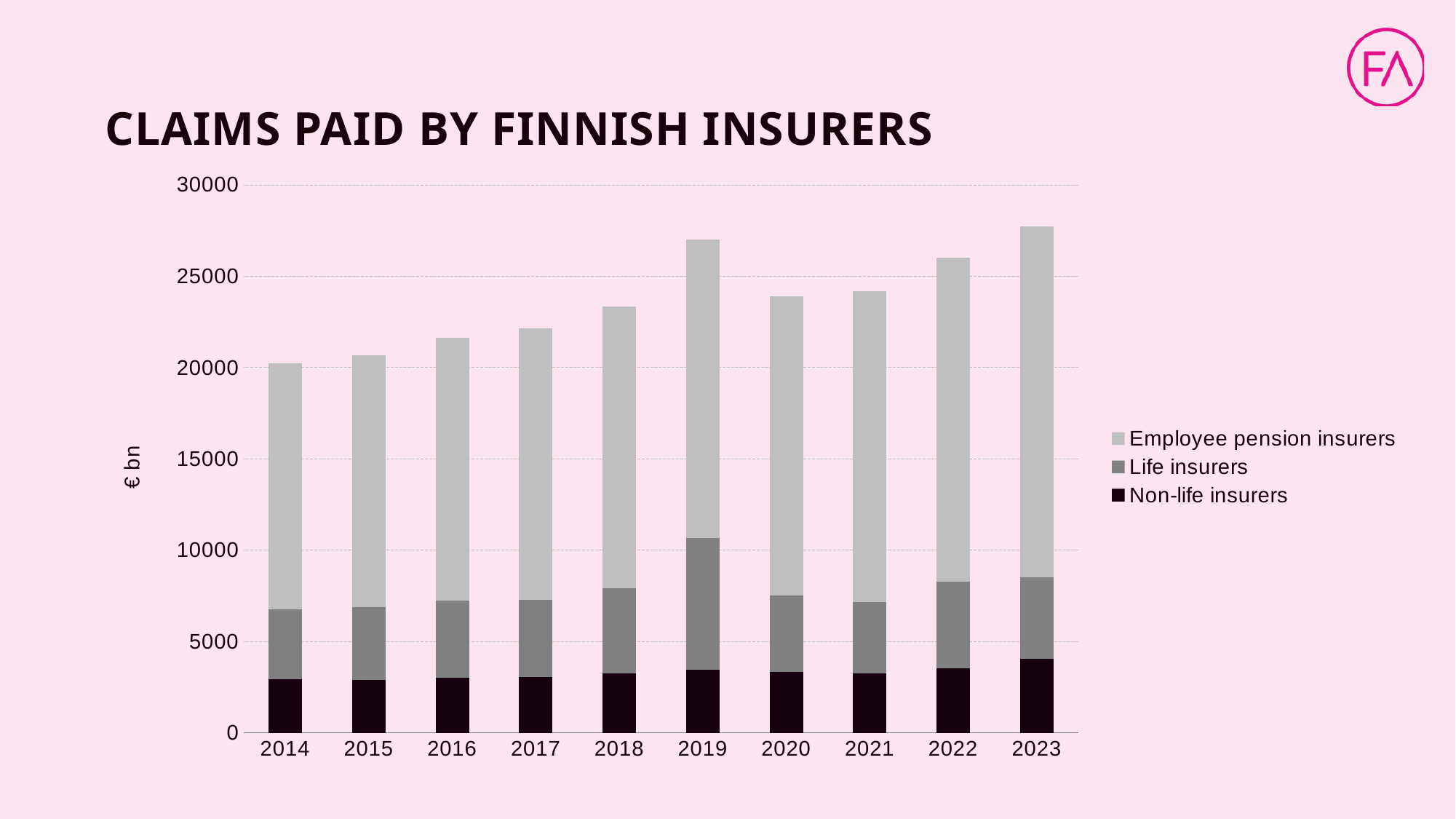
Is the total value for 2016 greater or less than 25000? less Which year has the highest total claims paid? 2023 How many years are shown on the x axis of the chart? 10 How many series does the chart's legend list? 3 What is the title of the chart? CLAIMS PAID BY FINNISH INSURERS Do the total claims paid generally rise or fall from 2014 to 2019? rise Which year has the larger total claims paid, 2021 or 2022? 2022 Which year has the larger total claims paid, 2019 or 2020? 2019 Which year has the lowest total claims paid? 2014 Is the total value for 2023 greater or less than 30000? less What kind of chart is shown on the slide? Stacked bar chart Is the total value for 2019 greater or less than 25000? greater